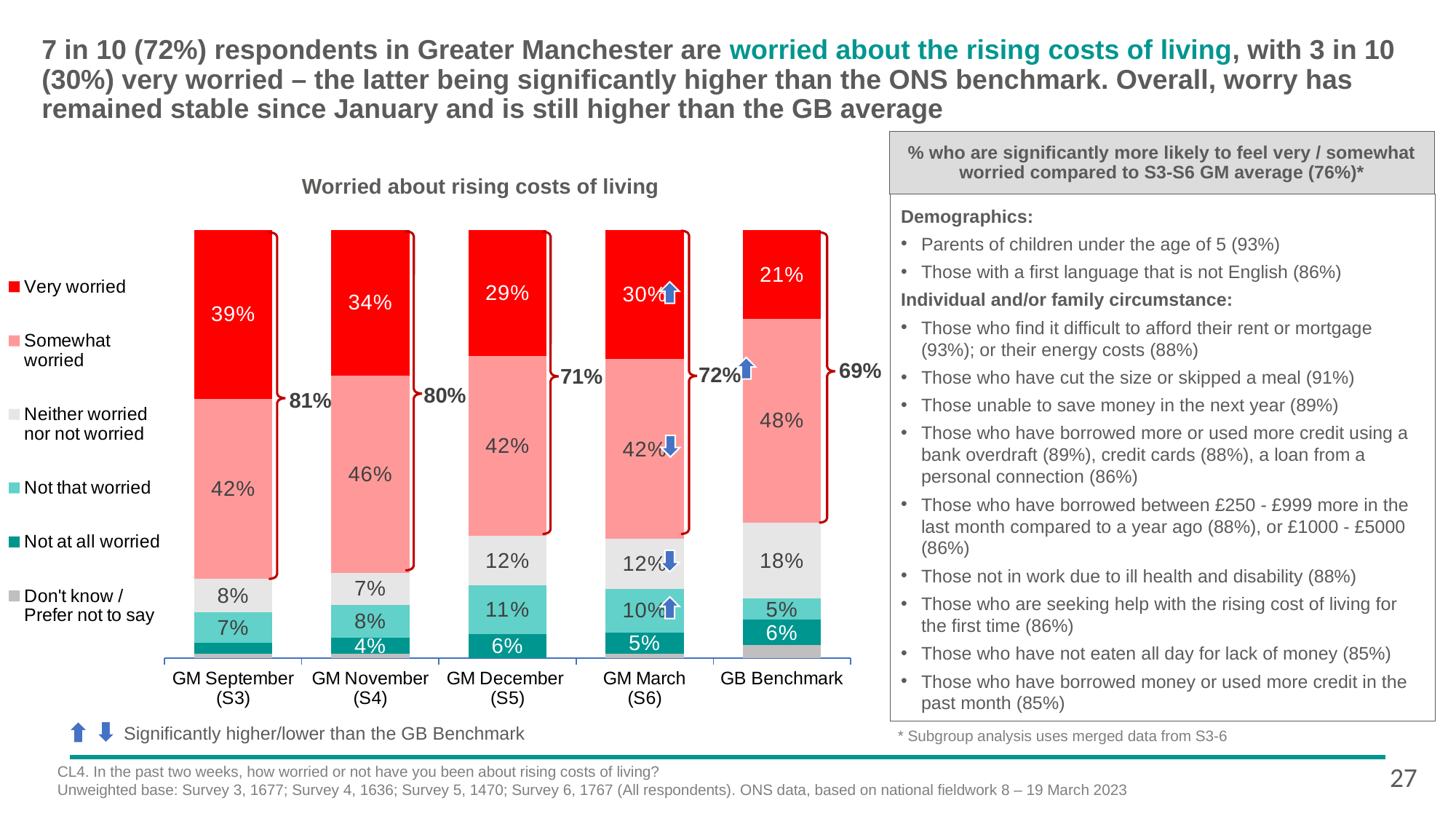
How many bars (categories) are shown on the x axis? 5 What is the combined very/somewhat worried percentage shown for GM March (S6)? 72% What percentage of GB Benchmark respondents were somewhat worried? 48% Which is larger: the 'Neither worried nor not worried' percentage for GB Benchmark or for GM December (S5)? GB Benchmark What is the difference between the 'Somewhat worried' percentage for GB Benchmark and for GM September (S3)? 6 percentage points Which bar has the lowest 'Very worried' percentage? GB Benchmark Which bar has the highest 'Very worried' percentage? GM September (S3) What percentage of GM September (S3) respondents were very worried? 39% What type of chart is shown on the slide? Stacked bar chart From GM September (S3) to GM December (S5), does the 'Very worried' percentage rise or fall? Fall How many series does the chart legend list? 6 What is the title of the chart? Worried about rising costs of living